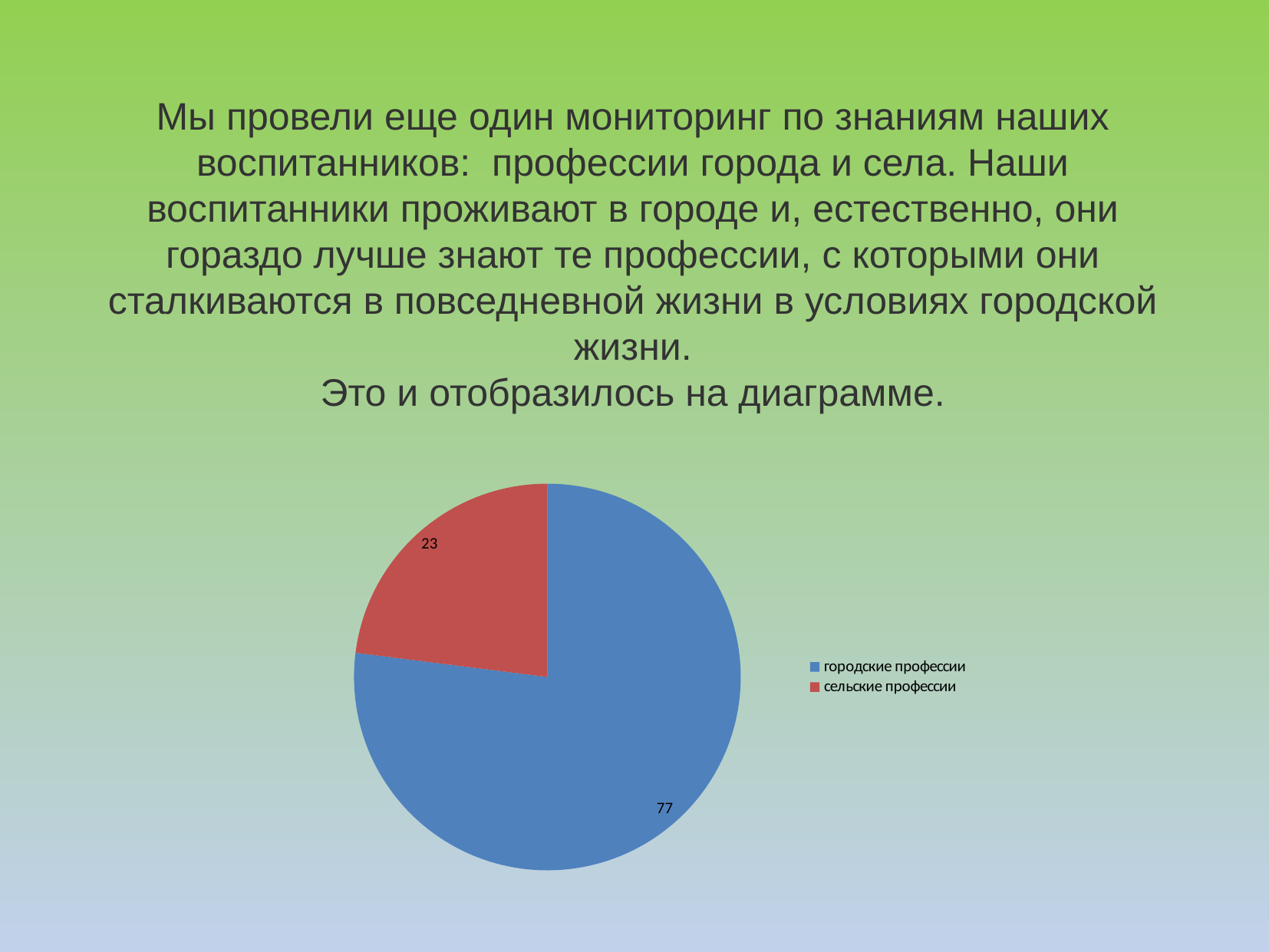
What kind of chart is shown on the slide? pie chart How many entries does the legend list? 2 Which category has the smallest slice of the pie? сельские профессии What colour is the slice for сельские профессии? red What share of the pie does городские профессии represent? 77% What share of the pie does сельские профессии represent? 23% Which category has the largest slice of the pie? городские профессии What is the difference between the values for городские профессии and сельские профессии? 54 How many slices does the pie chart have? 2 Which is larger, the value for городские профессии or the value for сельские профессии? городские профессии What is the value for сельские профессии? 23 What is the value for городские профессии? 77